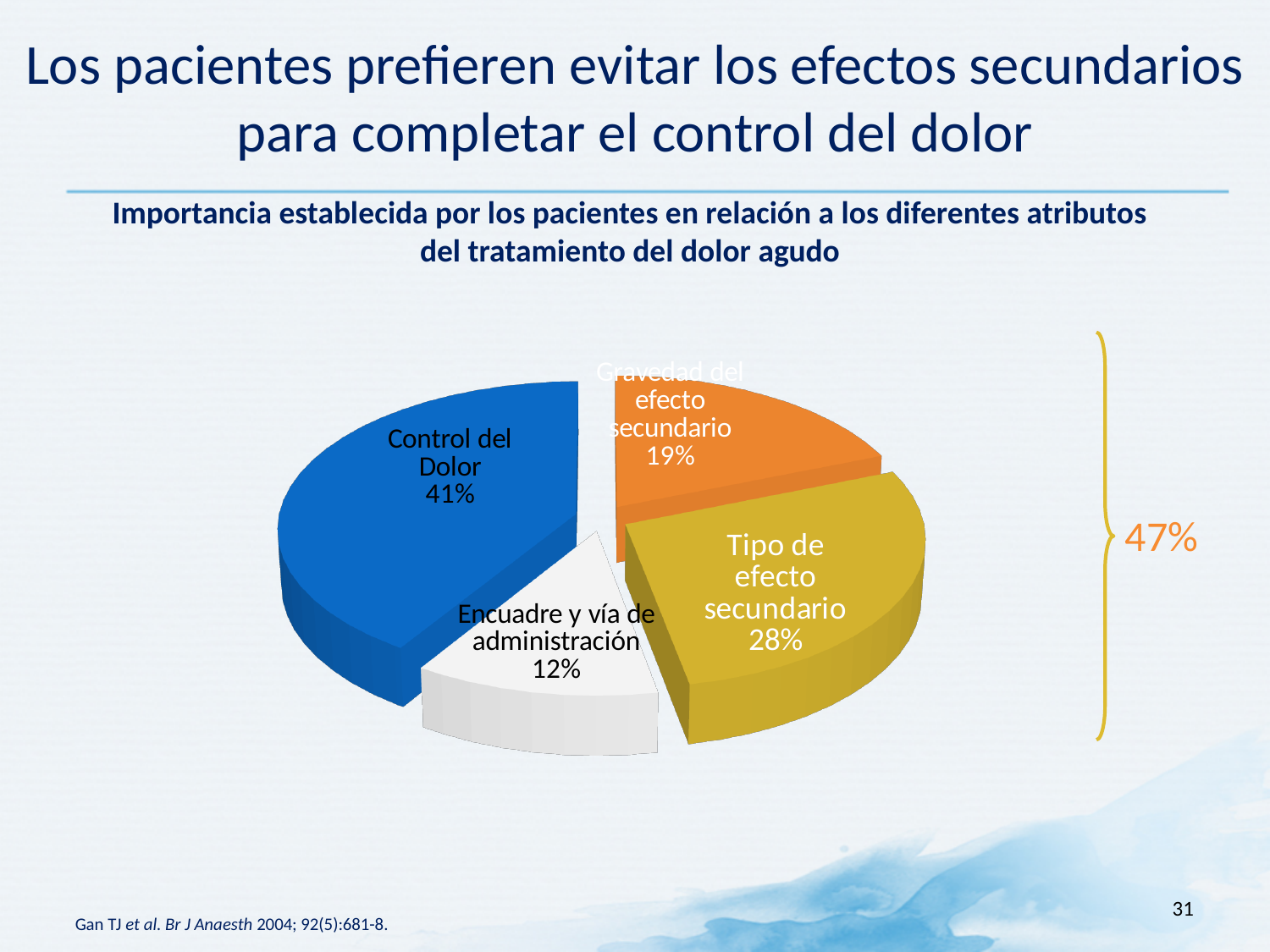
What percentage is shown for Control del Dolor? 41% Which slice of the pie chart is the largest? Control del Dolor What kind of chart is shown on the slide? Pie chart What percentage is shown for Tipo de efecto secundario? 28% What colour is the Control del Dolor slice? Blue What is the difference in percentage points between Control del Dolor and Tipo de efecto secundario? 13 What combined percentage is indicated by the bracket next to the pie chart? 47% What percentage is shown for Encuadre y vía de administración? 12% What percentage is shown for Gravedad del efecto secundario? 19% Which slice of the pie chart is the smallest? Encuadre y vía de administración How many slices does the pie chart have? 4 Which is larger, Gravedad del efecto secundario or Tipo de efecto secundario? Tipo de efecto secundario